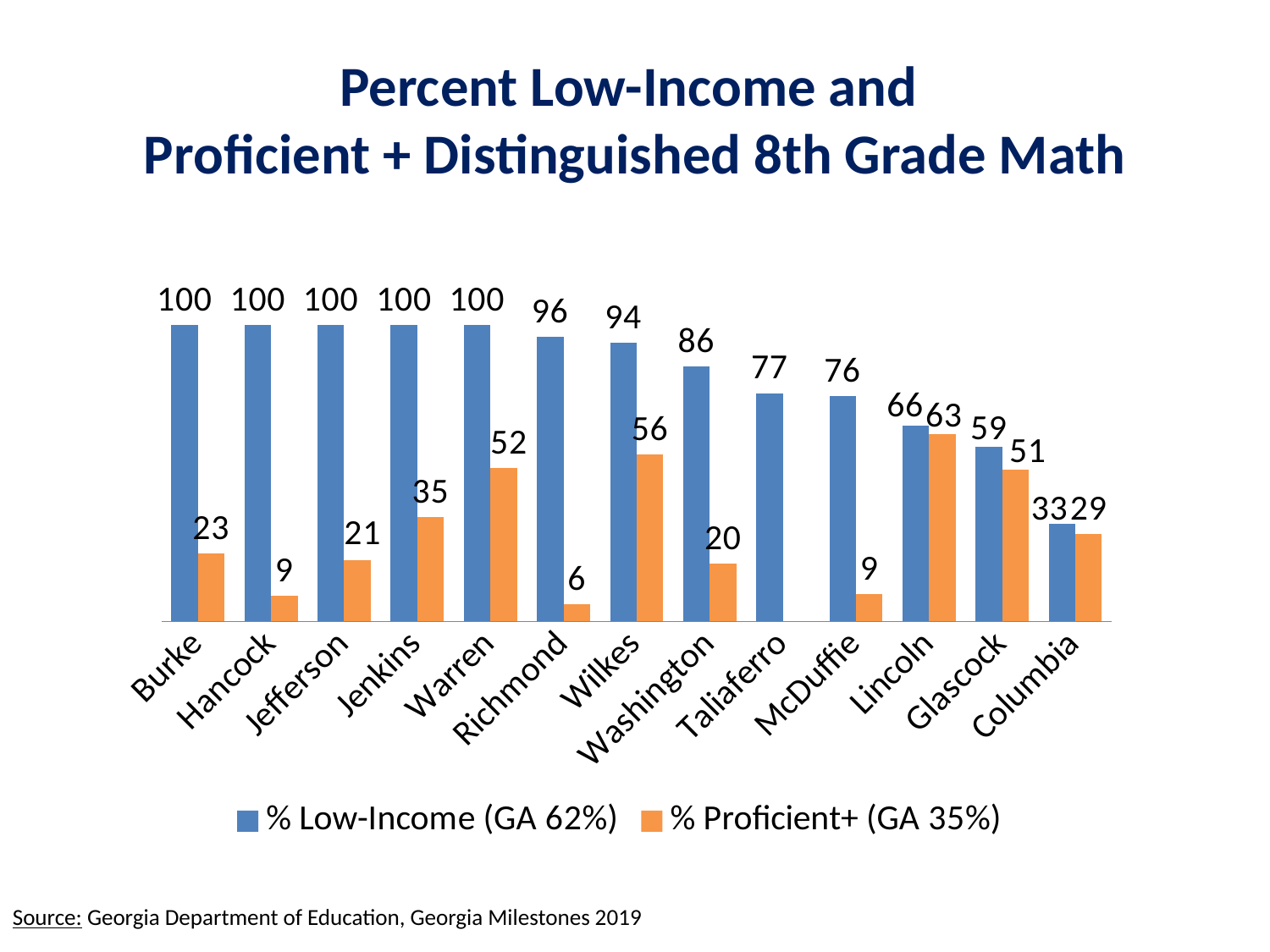
What kind of chart is shown on the slide? Bar chart Do the % Low-Income values rise or fall from left to right along the x axis? Fall How many counties are shown on the x axis? 13 Which county has the larger % Proficient+ value, Jenkins or Jefferson? Jenkins Which county has the lowest % Proficient+ value? Richmond Which county has the highest % Proficient+ value? Lincoln What is the % Proficient+ value for Glascock? 51 Which county has the lowest % Low-Income value? Columbia What is the % Low-Income value for Richmond? 96 How many series does the legend list? 2 What is the % Proficient+ value for Wilkes? 56 What is the difference between the % Low-Income and % Proficient+ values for Warren? 48